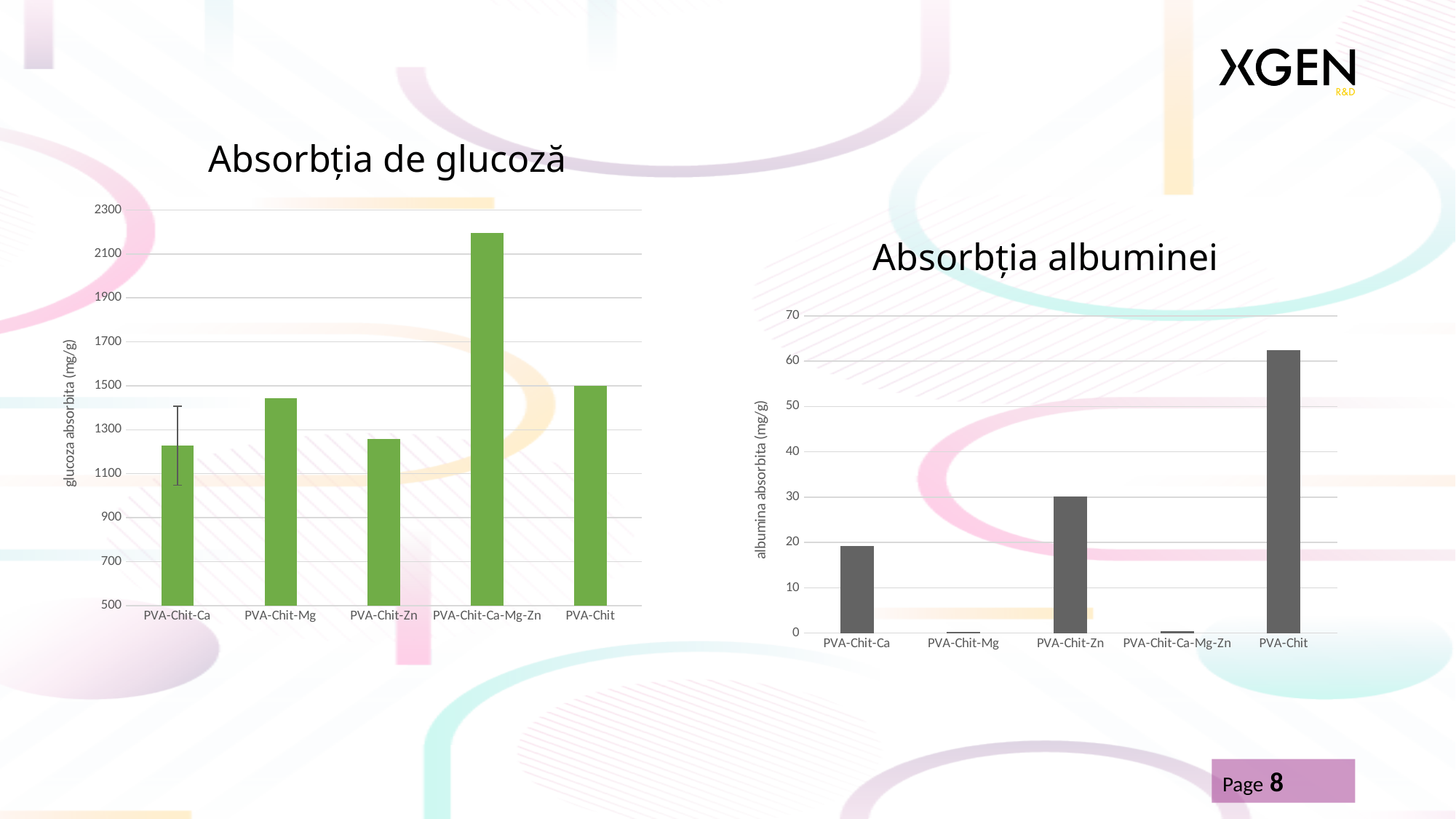
In the 'Absorbția de glucoză' chart, is the value for PVA-Chit-Ca-Mg-Zn greater or less than 2100? greater What is the y-axis label of the 'Absorbția de glucoză' chart? glucoza absorbita (mg/g) In the 'Absorbția albuminei' chart, is the value for PVA-Chit greater or less than 60? greater How many categories are shown on the 'Absorbția albuminei' chart? 5 In the 'Absorbția albuminei' chart, which is larger, the value for PVA-Chit-Zn or the value for PVA-Chit-Ca? PVA-Chit-Zn What is the y-axis label of the 'Absorbția albuminei' chart? albumina absorbita (mg/g) In the 'Absorbția de glucoză' chart, is the value for PVA-Chit-Ca greater or less than 1300? less In the 'Absorbția de glucoză' chart, which category has the highest value? PVA-Chit-Ca-Mg-Zn What kind of chart is the 'Absorbția de glucoză' chart? bar chart In the 'Absorbția de glucoză' chart, which is larger, the value for PVA-Chit-Mg or the value for PVA-Chit-Zn? PVA-Chit-Mg In the 'Absorbția albuminei' chart, which category has the highest value? PVA-Chit